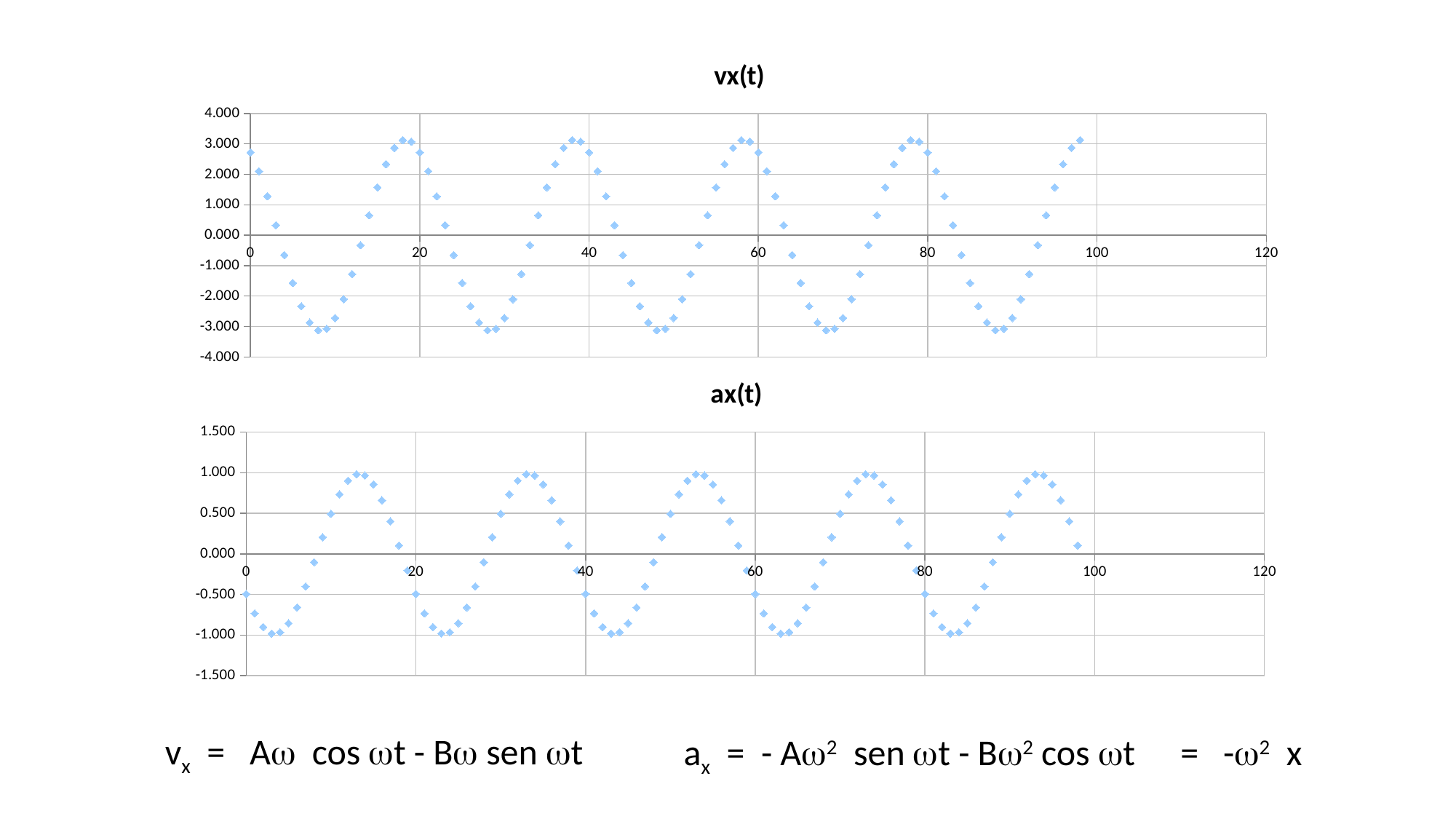
In the vx(t) chart, is the value at t = 0 greater or less than 2.000? greater What is the title of the bottom chart? ax(t) What is the title of the top chart? vx(t) What kind of chart is the ax(t) chart? scatter chart What kind of chart is the vx(t) chart? scatter chart How many charts are shown on the slide? 2 In the ax(t) chart, do the values rise or fall between t = 3 and t = 13? rise In the vx(t) chart, is the value at t = 10 greater or less than -2.000? less In the vx(t) chart, is the value at t = 40 greater or less than 2.000? greater In the vx(t) chart, do the values rise or fall between t = 0 and t = 8? fall